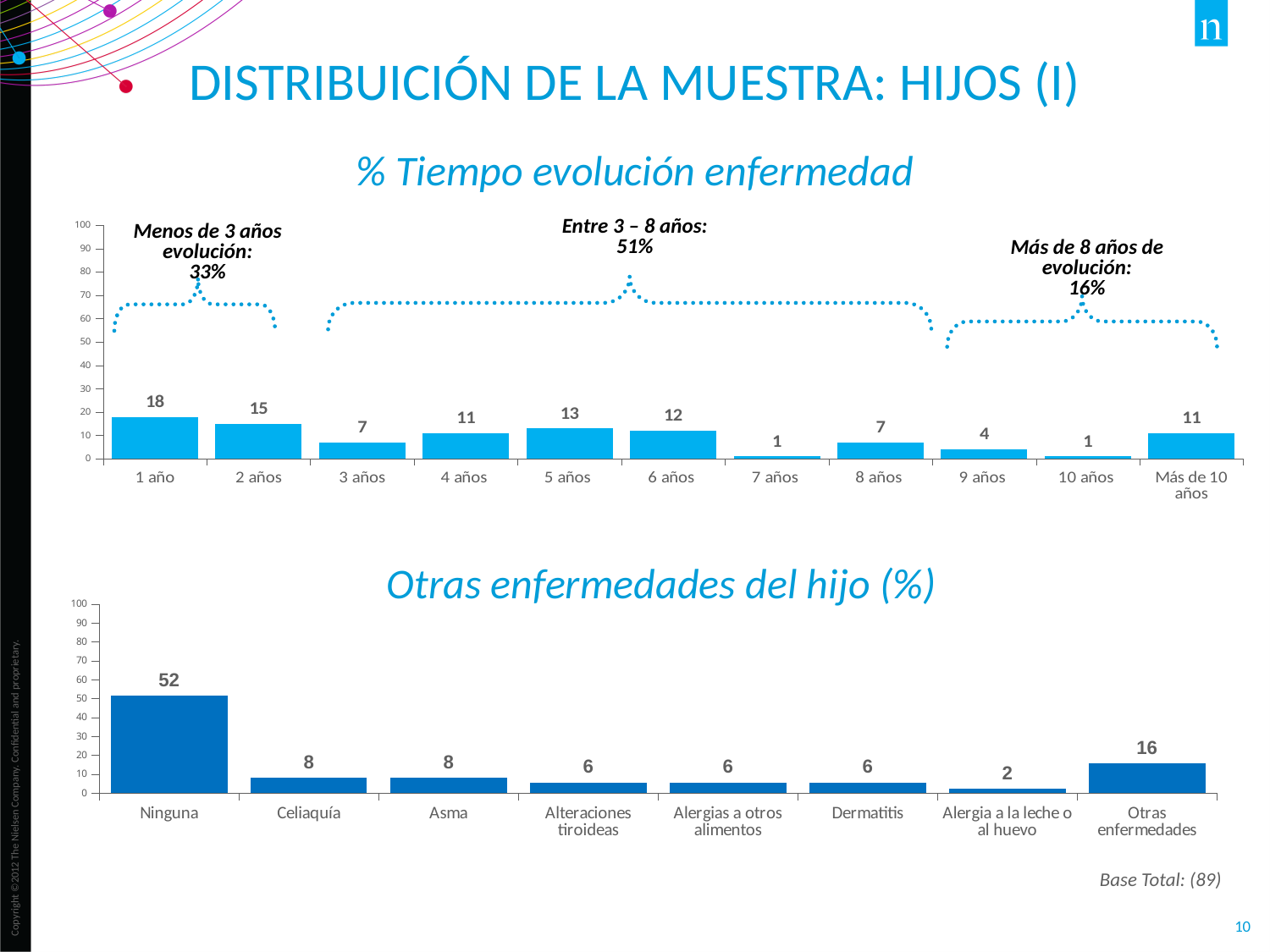
What type of chart is 'Otras enfermedades del hijo (%)'? Bar chart In the chart '% Tiempo evolución enfermedad', what percentage is given for 'Entre 3 – 8 años'? 51% In the chart '% Tiempo evolución enfermedad', what is the value for Más de 10 años? 11 In the chart '% Tiempo evolución enfermedad', which category has the highest value? 1 año In the chart 'Otras enfermedades del hijo (%)', what is the difference between the values for Ninguna and Otras enfermedades? 36 In the chart '% Tiempo evolución enfermedad', what is the value for 5 años? 13 In the chart '% Tiempo evolución enfermedad', how many categories are shown on the x axis? 11 In the chart 'Otras enfermedades del hijo (%)', which category has the lowest value? Alergia a la leche o al huevo In the chart '% Tiempo evolución enfermedad', what is the difference between the values for 1 año and 2 años? 3 In the chart 'Otras enfermedades del hijo (%)', how many categories are shown? 8 In the chart 'Otras enfermedades del hijo (%)', what is the value for Ninguna? 52 In the chart 'Otras enfermedades del hijo (%)', which is larger, Otras enfermedades or Celiaquía? Otras enfermedades